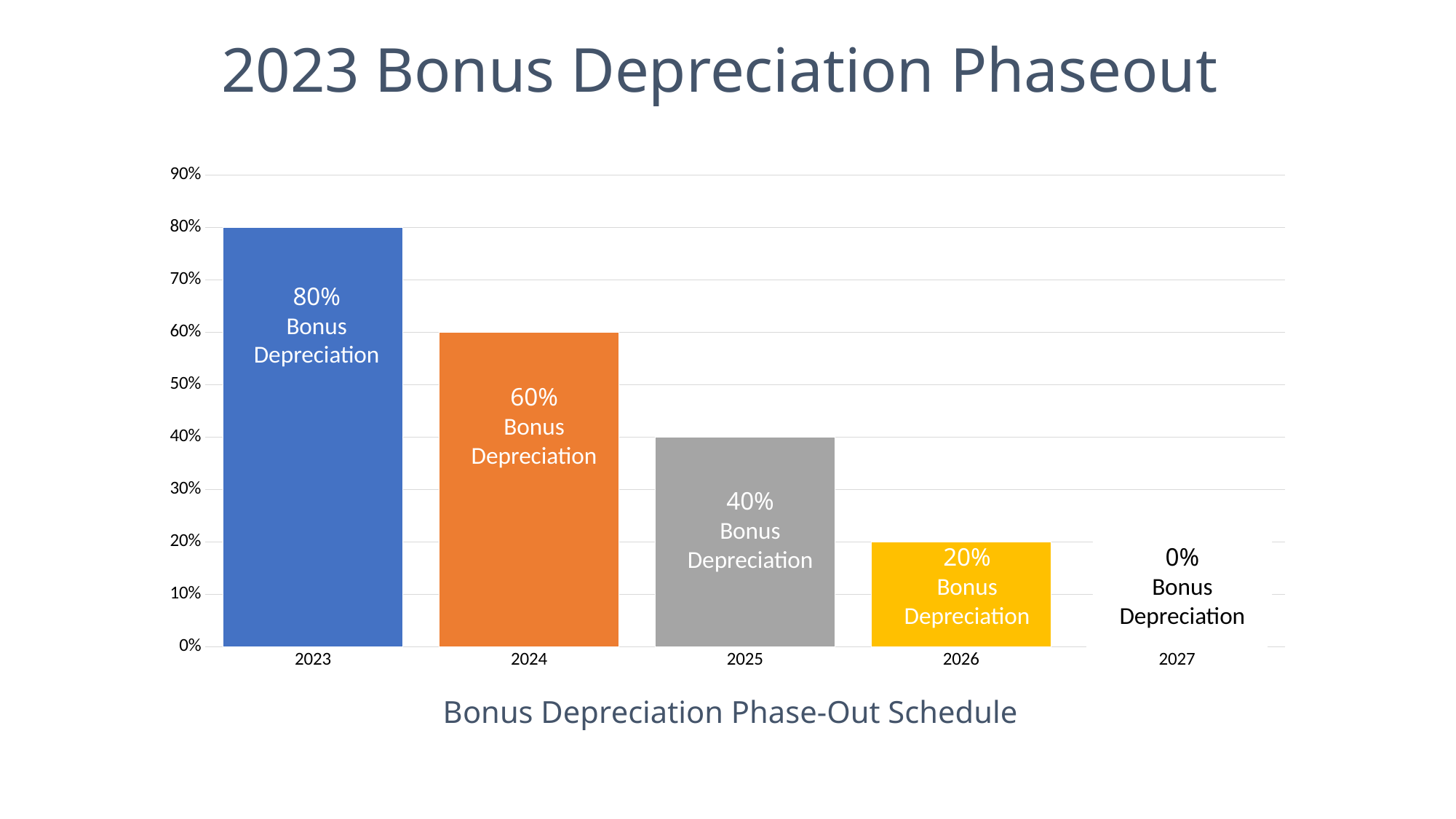
What is the bonus depreciation percentage for 2025? 40% Is the value for 2026 greater or less than 30%? less Do the bonus depreciation values rise or fall from 2023 to 2027? Fall What is the bonus depreciation percentage for 2027? 0% Which year has the lowest bonus depreciation percentage? 2027 Which year has a larger bonus depreciation percentage, 2024 or 2025? 2024 What kind of chart is shown on the slide? Bar chart Which year has the highest bonus depreciation percentage? 2023 What is the difference between the bonus depreciation percentages for 2024 and 2026? 40% What is the title of the chart below the x axis? Bonus Depreciation Phase-Out Schedule What is the bonus depreciation percentage for 2023? 80% How many years are shown on the x axis? 5